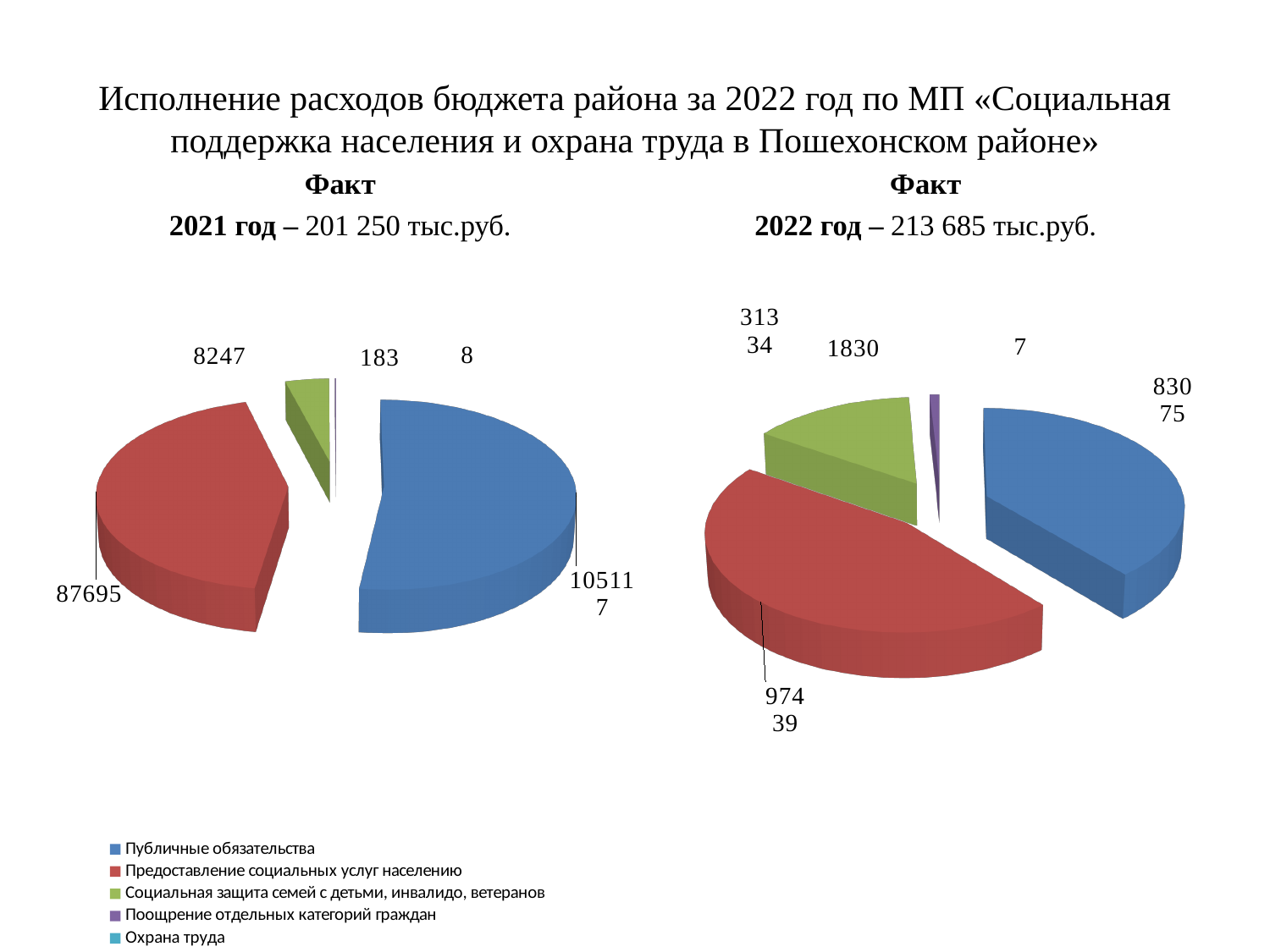
In the 2021 pie chart, which category has the largest slice? Публичные обязательства In the 2021 pie chart, what is the value for Социальная защита семей с детьми, инвалидо, ветеранов? 8247 What kind of charts are shown on the slide? Pie charts In the 2022 pie chart, which is larger: Публичные обязательства or Предоставление социальных услуг населению? Предоставление социальных услуг населению In the 2022 pie chart, which category has the largest slice? Предоставление социальных услуг населению In the 2021 pie chart, what is the value for Охрана труда? 8 In the 2021 pie chart, what is the difference between Социальная защита семей с детьми, инвалидо, ветеранов and Поощрение отдельных категорий граждан? 8064 How many series does the legend list? 5 In the 2021 pie chart, what is the value for Поощрение отдельных категорий граждан? 183 In the 2022 pie chart, what is the value for Поощрение отдельных категорий граждан? 1830 In the 2021 pie chart, what is the value for Предоставление социальных услуг населению? 87695 In the 2022 pie chart, what is the value for Охрана труда? 7